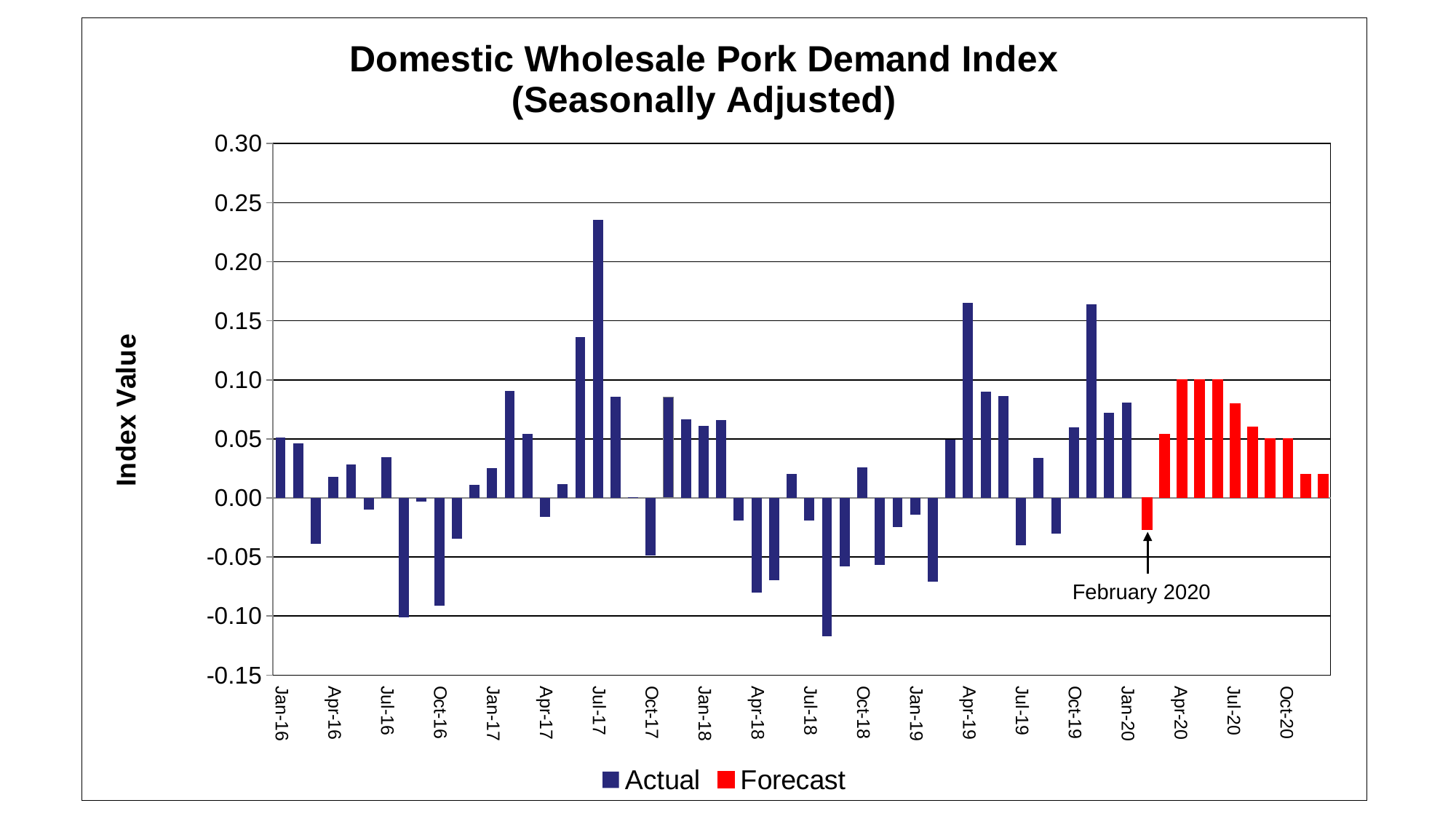
What is the label on the vertical axis? Index Value How many series does the legend list? 2 Is the value for Apr-18 greater or less than -0.05? less Do the forecast values rise or fall from Apr-20 to Dec-20? fall Is the value for Apr-19 greater or less than 0.15? greater Is the value for Jul-17 greater or less than 0.20? greater What are the two series named in the legend? Actual and Forecast What kind of chart is shown on the slide? Bar chart Which month has the highest index value on the chart? Jul-17 Which is larger, the value for Jul-17 or the value for Apr-19? Jul-17